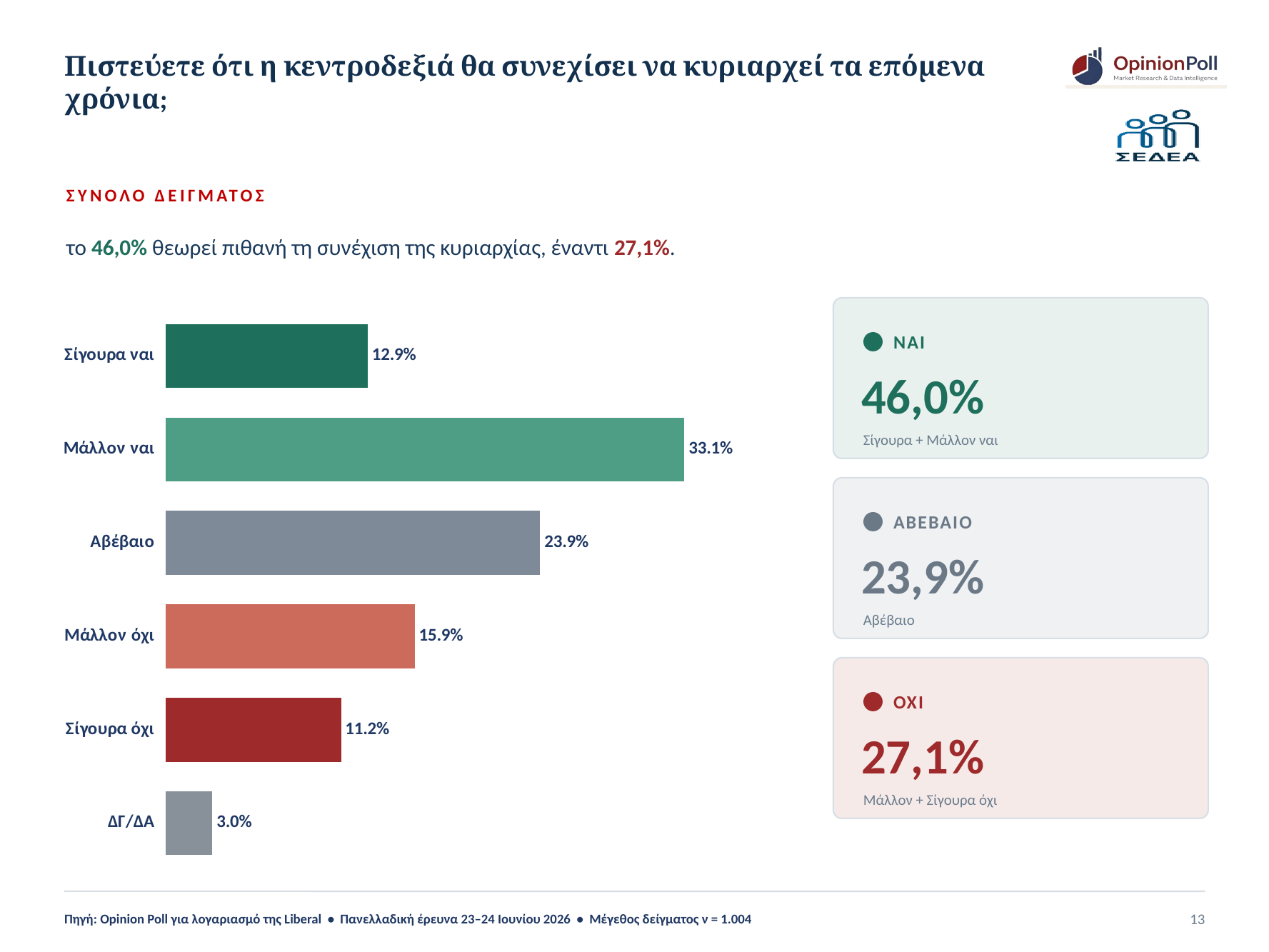
What is the combined value shown for ΝΑΙ (Σίγουρα + Μάλλον ναι) in the summary box? 46,0% How many categories are shown in the bar chart? 6 What is the value for Σίγουρα όχι? 11.2% What kind of chart is shown on the slide? bar chart Which category has the highest value? Μάλλον ναι What colour is the bar for Σίγουρα όχι? dark red Which category has the lowest value? ΔΓ/ΔΑ What is the value for Μάλλον ναι? 33.1% What is the value for ΔΓ/ΔΑ? 3.0% Which is larger, Σίγουρα ναι or Μάλλον όχι? Μάλλον όχι What is the difference between Μάλλον όχι and Σίγουρα ναι? 3.0% What is the difference between Μάλλον ναι and Αβέβαιο? 9.2%